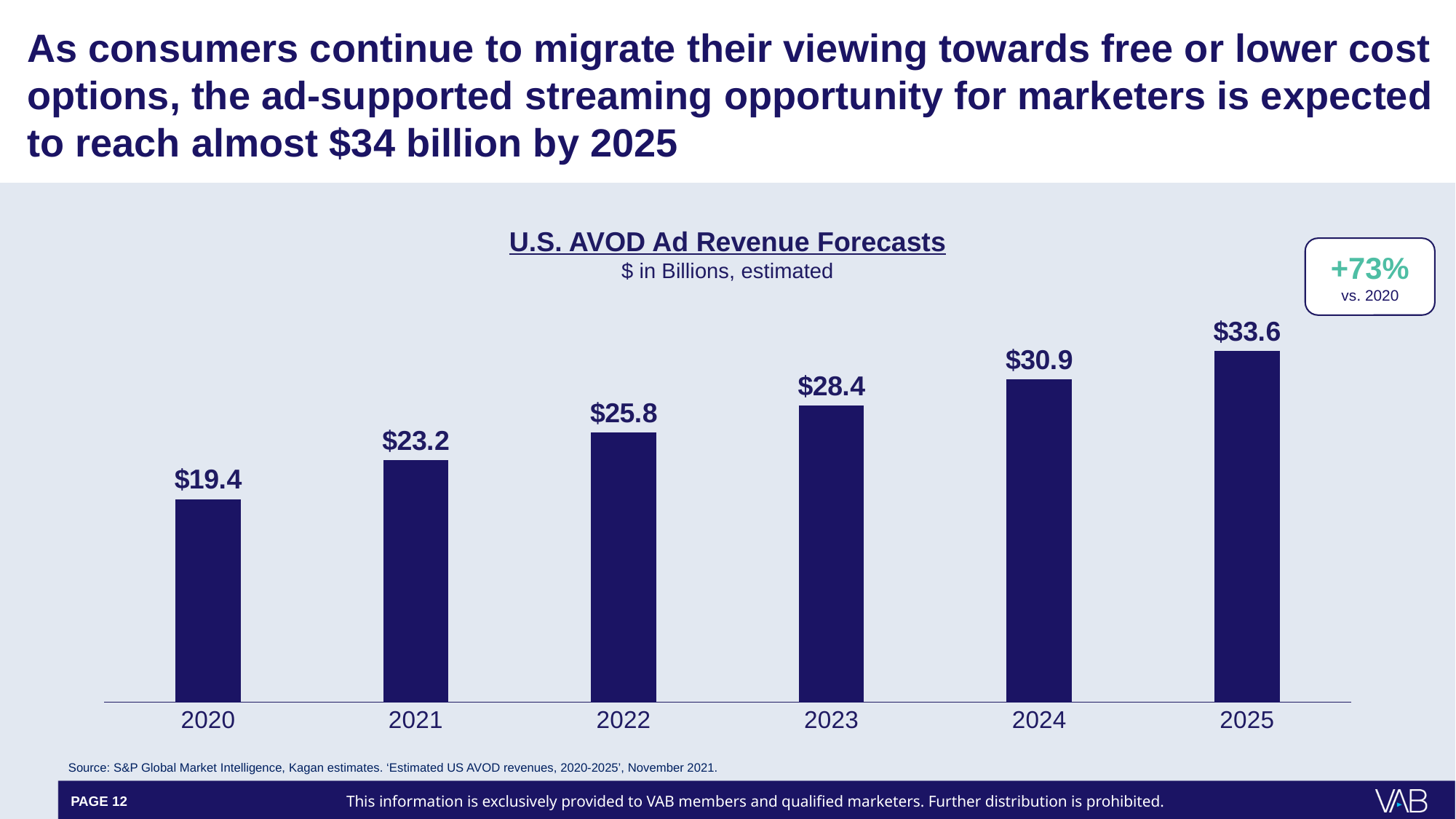
What is the difference between the 2025 and 2020 forecast values? $14.2 What is the forecast U.S. AVOD ad revenue for 2024? $30.9 How many years are shown on the chart? 6 Which year has the highest forecast AVOD ad revenue? 2025 What is the forecast U.S. AVOD ad revenue for 2022? $25.8 What percentage growth vs. 2020 is called out in the box on the chart? +73% Do the forecast values rise or fall from 2020 to 2025? Rise Which year has a larger forecast value, 2021 or 2023? 2023 What is the difference between the 2023 and 2021 forecast values? $5.2 What is the forecast U.S. AVOD ad revenue for 2020? $19.4 Which year has the lowest forecast AVOD ad revenue? 2020 What kind of chart is shown on the slide? Bar chart